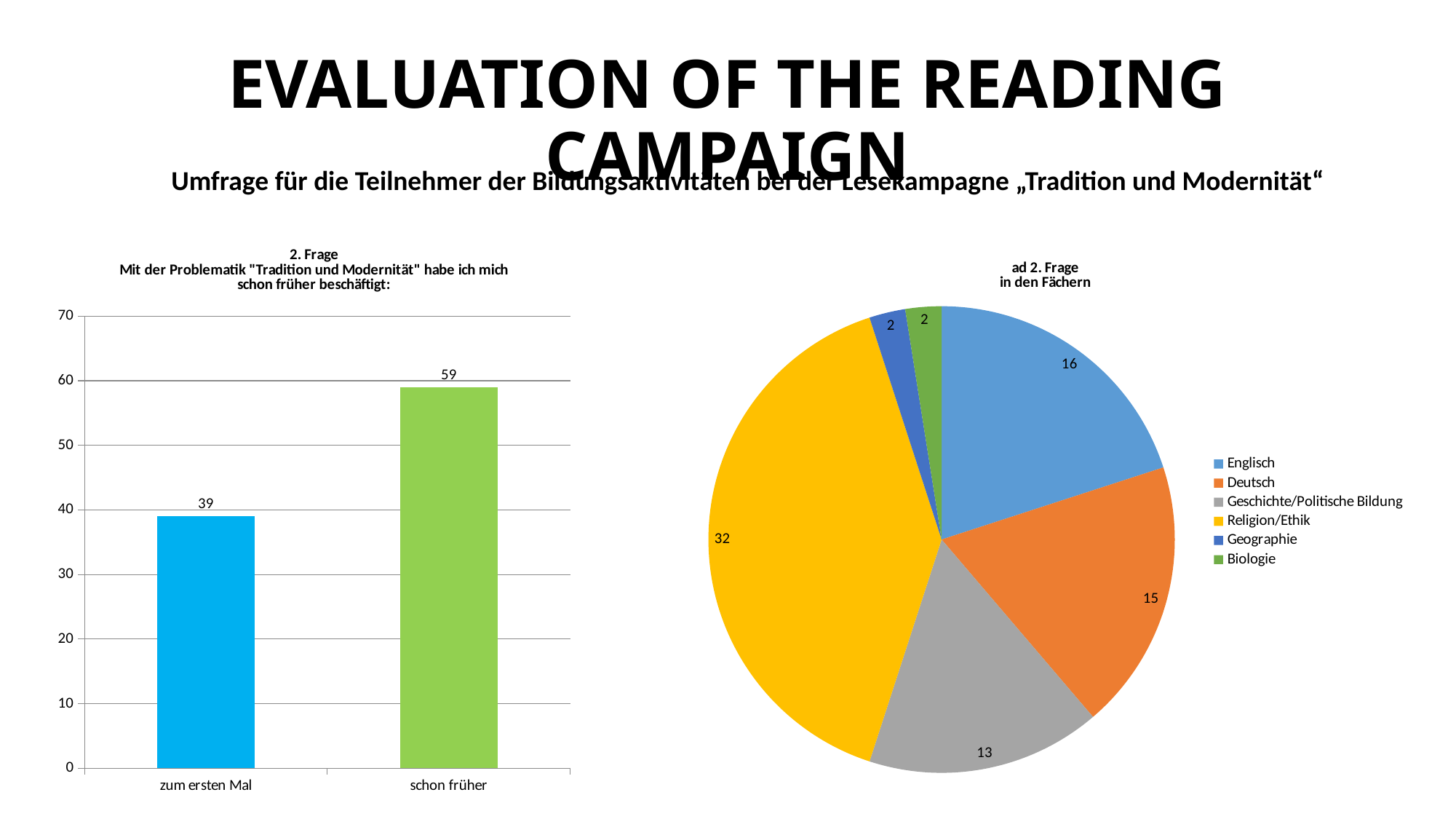
In the pie chart on the right, which is larger, Englisch or Deutsch? Englisch In the pie chart on the right, what is the difference between Religion/Ethik and Englisch? 16 In the pie chart on the right, how many subjects does the legend list? 6 In the pie chart on the right, what is the value for Geschichte/Politische Bildung? 13 In the bar chart on the left, what is the value for "zum ersten Mal"? 39 What kind of chart is the chart on the left? bar chart In the pie chart on the right, what share of the total does Religion/Ethik represent? 40% In the bar chart on the left, what is the value for "schon früher"? 59 In the pie chart on the right, which subject has the largest slice? Religion/Ethik In the bar chart on the left, what is the difference between "schon früher" and "zum ersten Mal"? 20 In the pie chart on the right, what is the value for Religion/Ethik? 32 In the bar chart on the left, which category has the higher value? schon früher